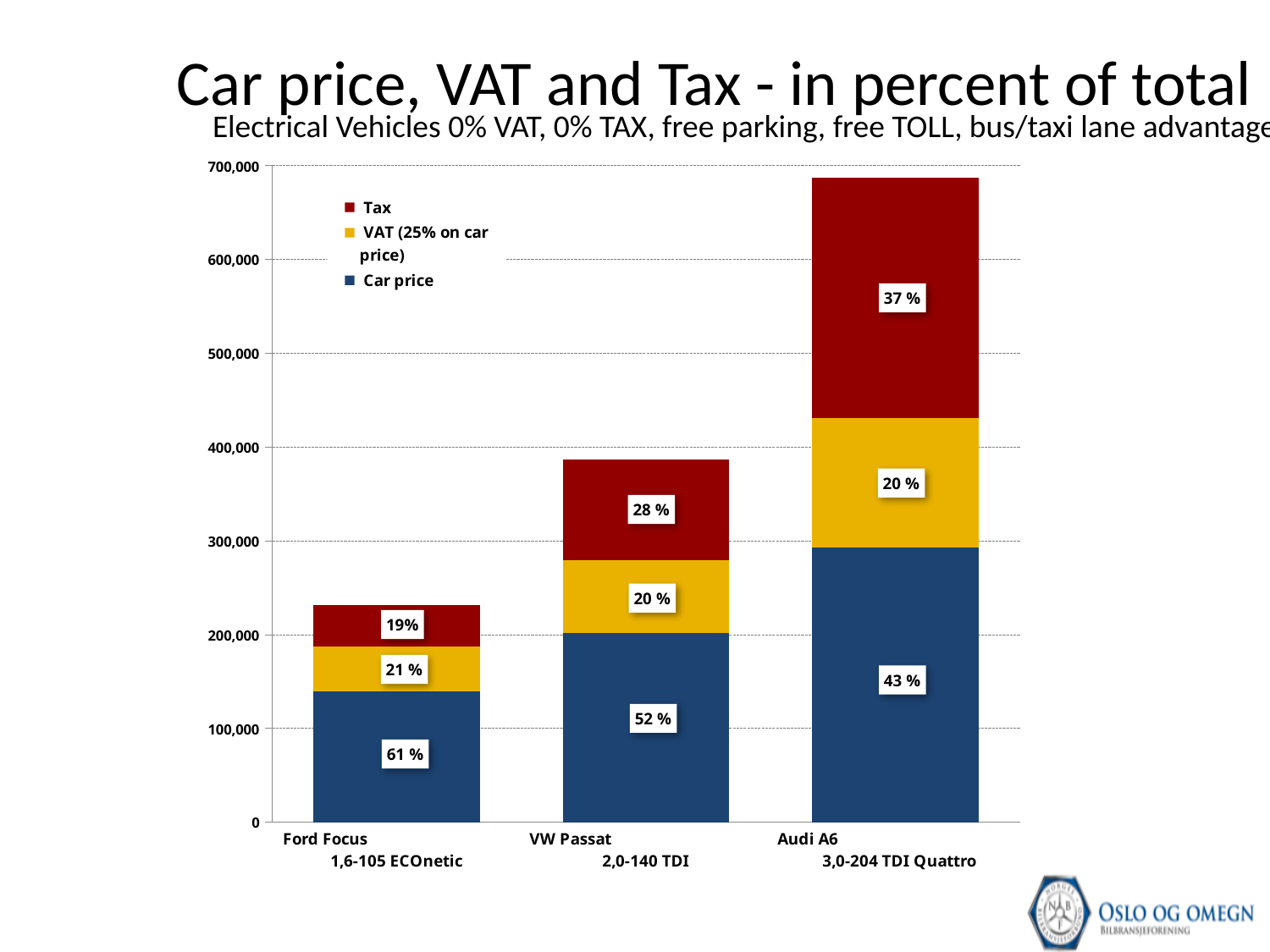
Which is larger, the Tax share for the Audi A6 or the Tax share for the Ford Focus? Audi A6 Which car has the tallest total bar? Audi A6 3,0-204 TDI Quattro Which car has the shortest total bar? Ford Focus 1,6-105 ECOnetic What is the Tax share for the Audi A6 3,0-204 TDI Quattro? 37 % What is the VAT share for the VW Passat 2,0-140 TDI? 20 % Is the total bar for the Audi A6 3,0-204 TDI Quattro greater or less than 600,000? greater What is the Tax share for the Ford Focus 1,6-105 ECOnetic? 19% What is the Car price share for the Ford Focus 1,6-105 ECOnetic? 61 % How many series does the legend list? 3 What kind of chart is shown on the slide? Stacked bar chart Is the total bar for the VW Passat 2,0-140 TDI greater or less than 400,000? less How many cars (categories) are shown on the x axis? 3